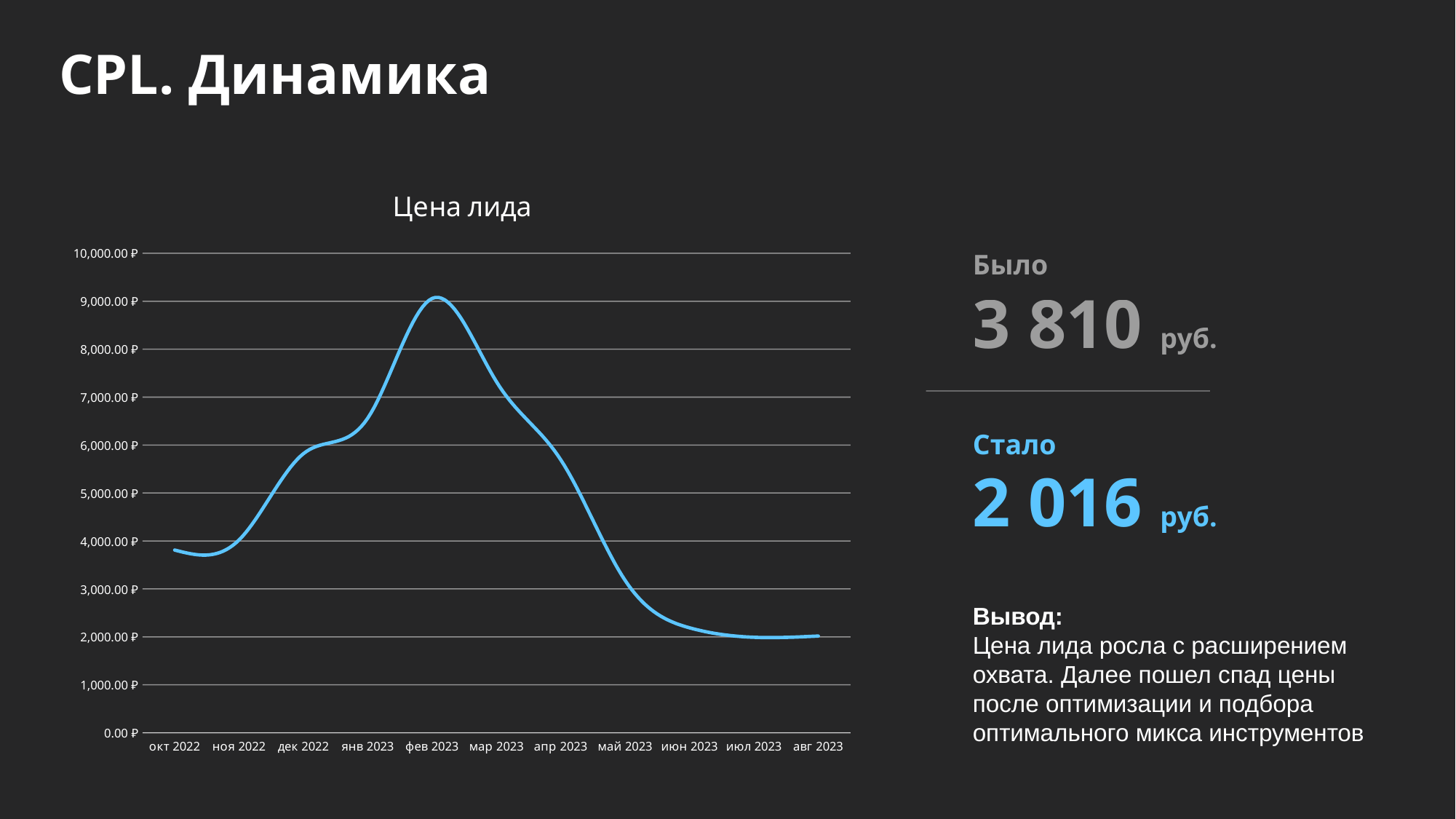
Which month has the larger value, дек 2022 or июн 2023? дек 2022 What is the title of the chart? Цена лида What kind of chart is shown on the slide? line chart Is the value for мар 2023 greater or less than 6,000.00 ₽? greater In which month does the line reach its highest value? фев 2023 Is the value for фев 2023 greater or less than 8,000.00 ₽? greater Which month has the larger value, фев 2023 or авг 2023? фев 2023 Is the value for авг 2023 greater or less than 3,000.00 ₽? less What colour is the line in the chart? blue Do the values rise or fall from фев 2023 to авг 2023? fall How many months are plotted along the x axis of the chart? 11